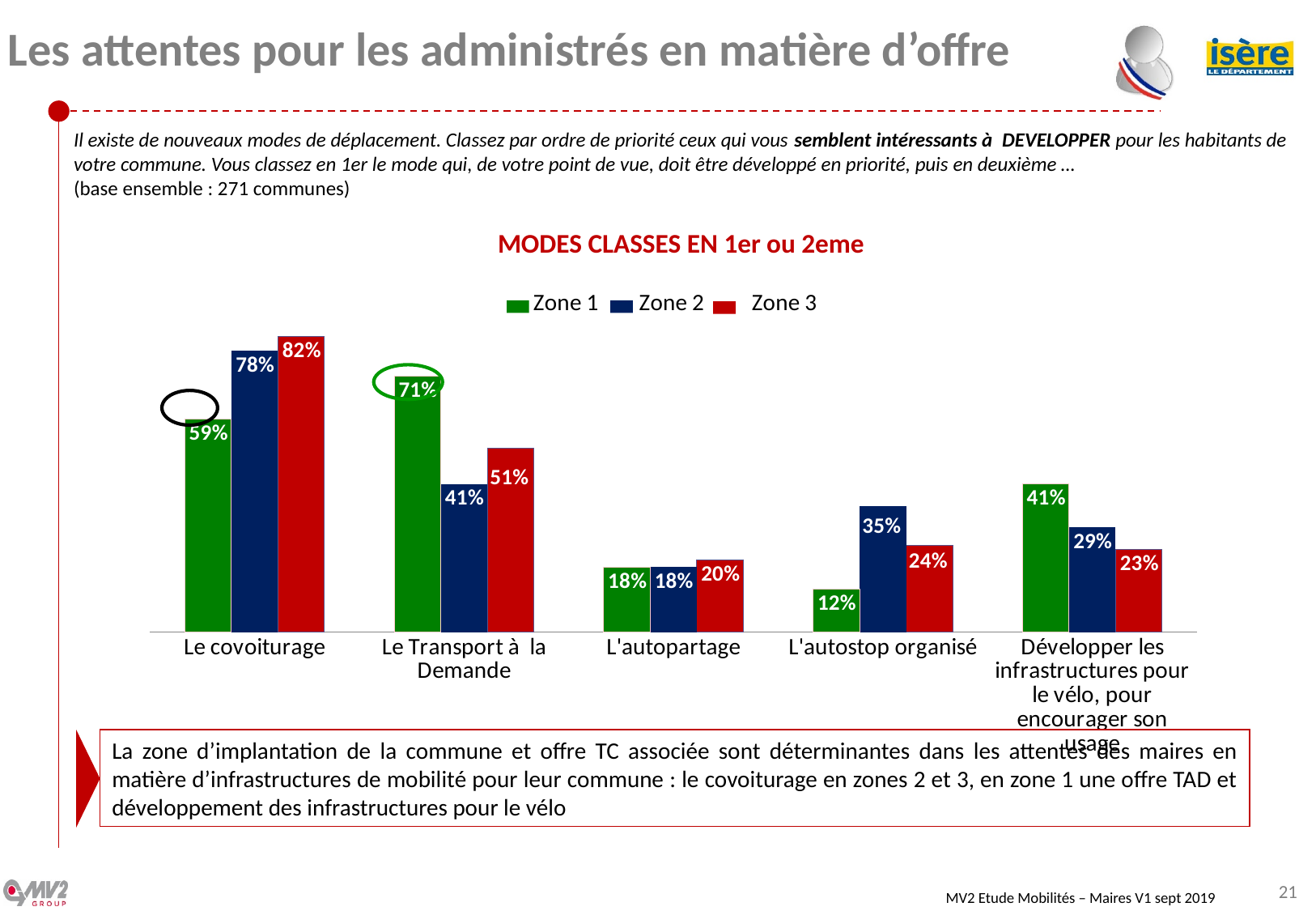
What is the value for Zone 3 for L'autopartage? 20% What is the value for Zone 1 for Le Transport à la Demande? 71% For Le Transport à la Demande, which is larger: the Zone 1 value or the Zone 3 value? Zone 1 Which category has the highest value for Zone 2? Le covoiturage What kind of chart is shown on the slide? Bar chart What is the title of the chart? MODES CLASSES EN 1er ou 2eme What is the difference between the Zone 3 and Zone 1 values for Le covoiturage? 23 percentage points What is the value for Zone 2 for L'autostop organisé? 35% How many categories are shown on the x axis? 5 Which category has the lowest value for Zone 1? L'autostop organisé How many series does the legend list? 3 What is the value for Zone 3 for Le covoiturage? 82%